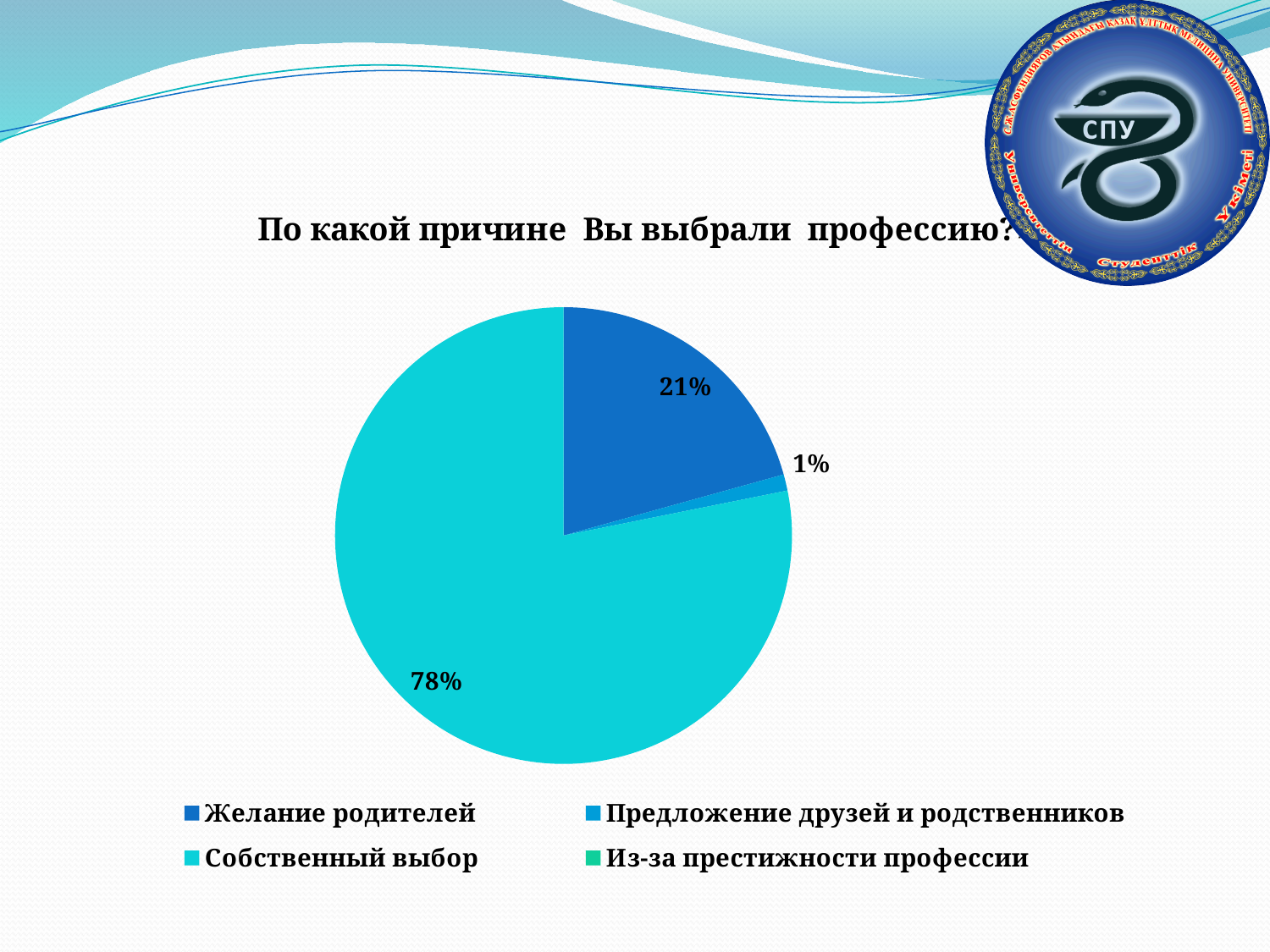
What is the title of the chart? По какой причине Вы выбрали профессию? What share of the pie is labelled for "Желание родителей"? 21% Which is larger, the slice for "Желание родителей" or the slice for "Предложение друзей и родственников"? Желание родителей What is the difference in percentage points between "Собственный выбор" and "Желание родителей"? 57 How many slices with percentage labels are shown in the pie? 3 Which category has the largest slice of the pie? Собственный выбор What kind of chart is shown on the slide? pie chart What share of the pie is labelled for "Предложение друзей и родственников"? 1% What colour is the slice for "Собственный выбор"? cyan (light blue) What share of the pie is labelled for "Собственный выбор"? 78% How many categories does the legend list? 4 Which labelled slice of the pie is the smallest? Предложение друзей и родственников